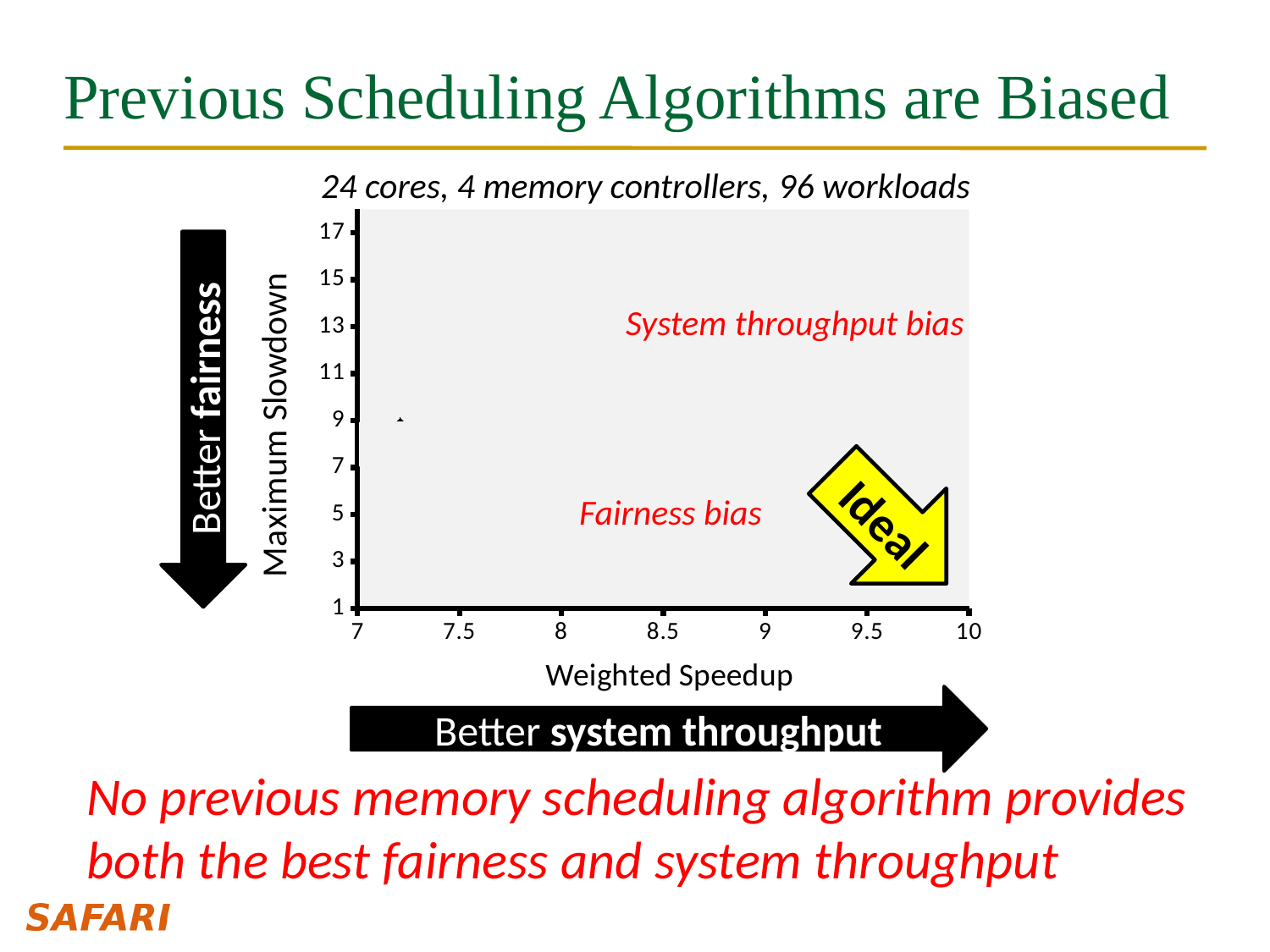
Is the Weighted Speedup of the plotted point greater or less than 8? less What is the title of the chart? 24 cores, 4 memory controllers, 96 workloads Is the Weighted Speedup of the plotted point greater or less than 7.5? less What is the label of the y axis of the chart? Maximum Slowdown How many data points are plotted on the chart? 1 Is the Maximum Slowdown of the plotted point greater or less than 7? greater What kind of chart is shown on the slide? scatter chart